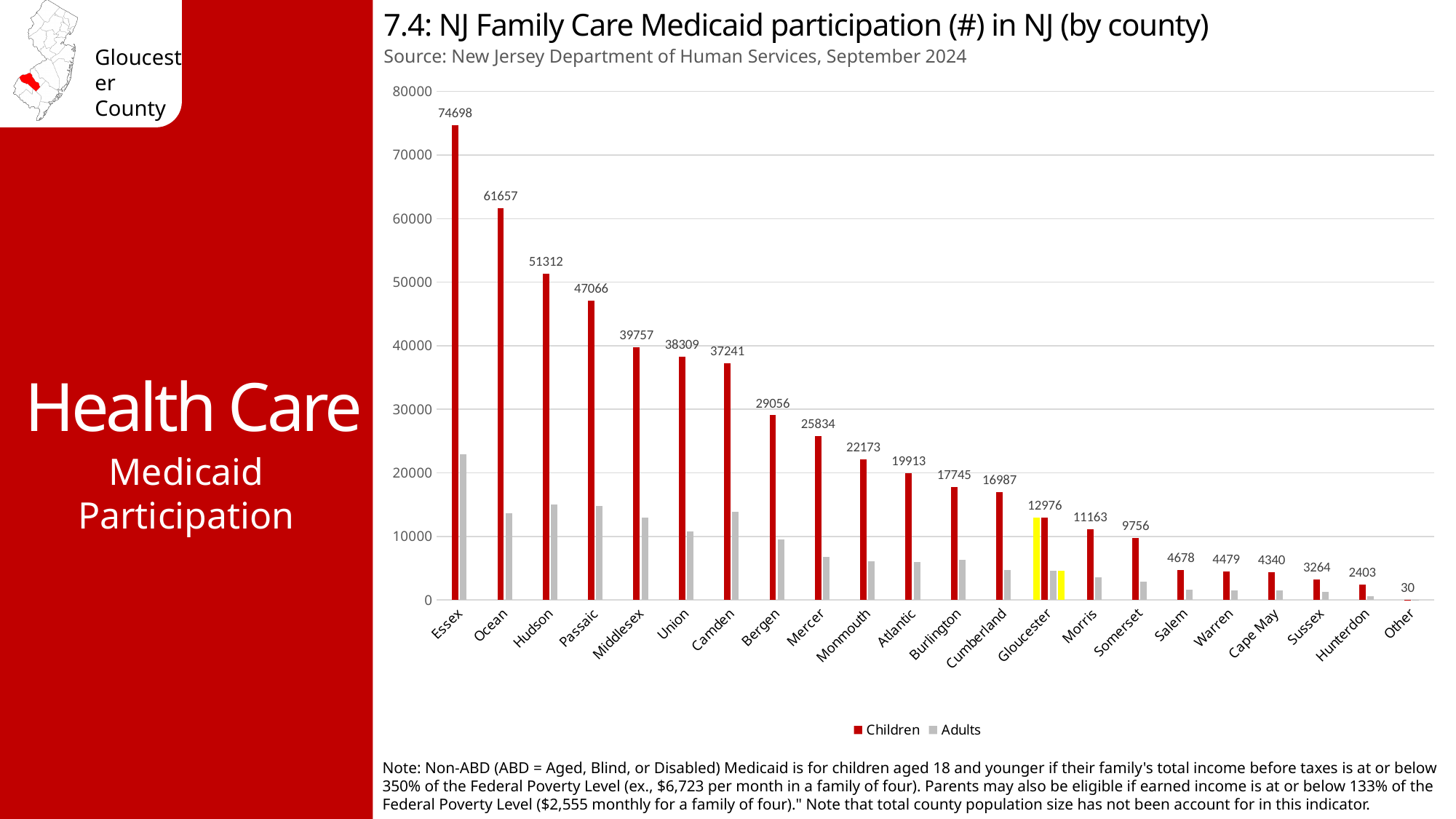
How many categories are shown on the x axis? 22 How many series does the legend list? 2 Which county has the highest Children value? Essex Which has a larger Children value, Bergen or Mercer? Bergen What is the difference between the Children values for Essex and Ocean? 13041 What is the Children value for Gloucester? 12976 Is the Adults value for Essex greater or less than 20000? greater Which category has the lowest Children value? Other What is the Children value for Essex? 74698 What kind of chart is shown? Bar chart Is the Adults value for Gloucester greater or less than 10000? less What is the Children value for Camden? 37241